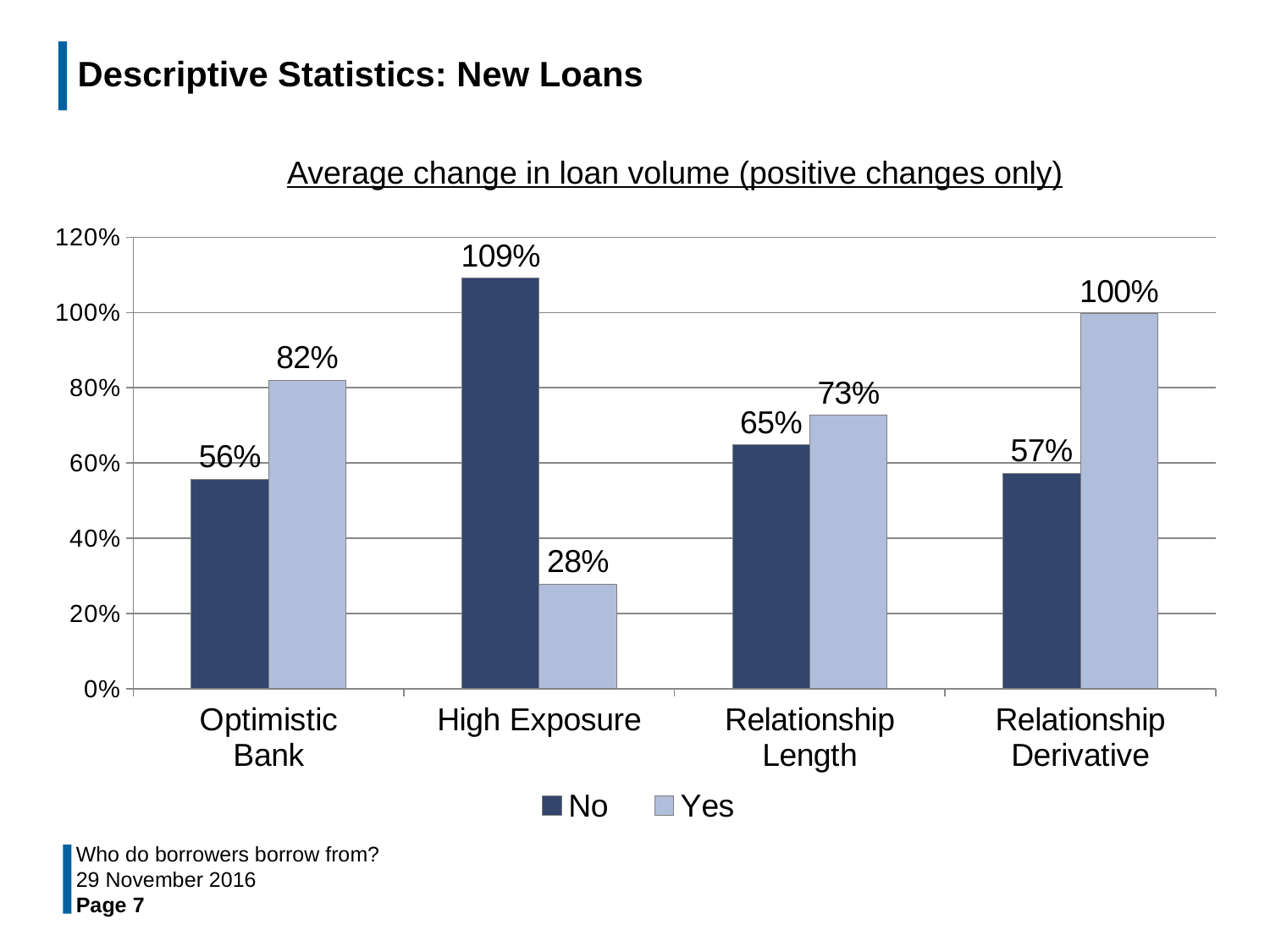
What is the value for "Yes" in the High Exposure category? 28% Which category has the lowest value for the "Yes" series? High Exposure Is the value for "No" in the High Exposure category greater or less than 100%? greater How many series does the legend list? 2 Which category has the highest value for the "No" series? High Exposure In the Relationship Length category, which is larger, the "No" value or the "Yes" value? Yes What kind of chart is shown on the slide? Bar chart What is the difference between the "Yes" and "No" values in the Relationship Derivative category? 43% What is the value for "Yes" in the Relationship Derivative category? 100% How many categories are shown on the x axis? 4 What is the value for "No" in the Optimistic Bank category? 56% What is the title of the chart? Average change in loan volume (positive changes only)